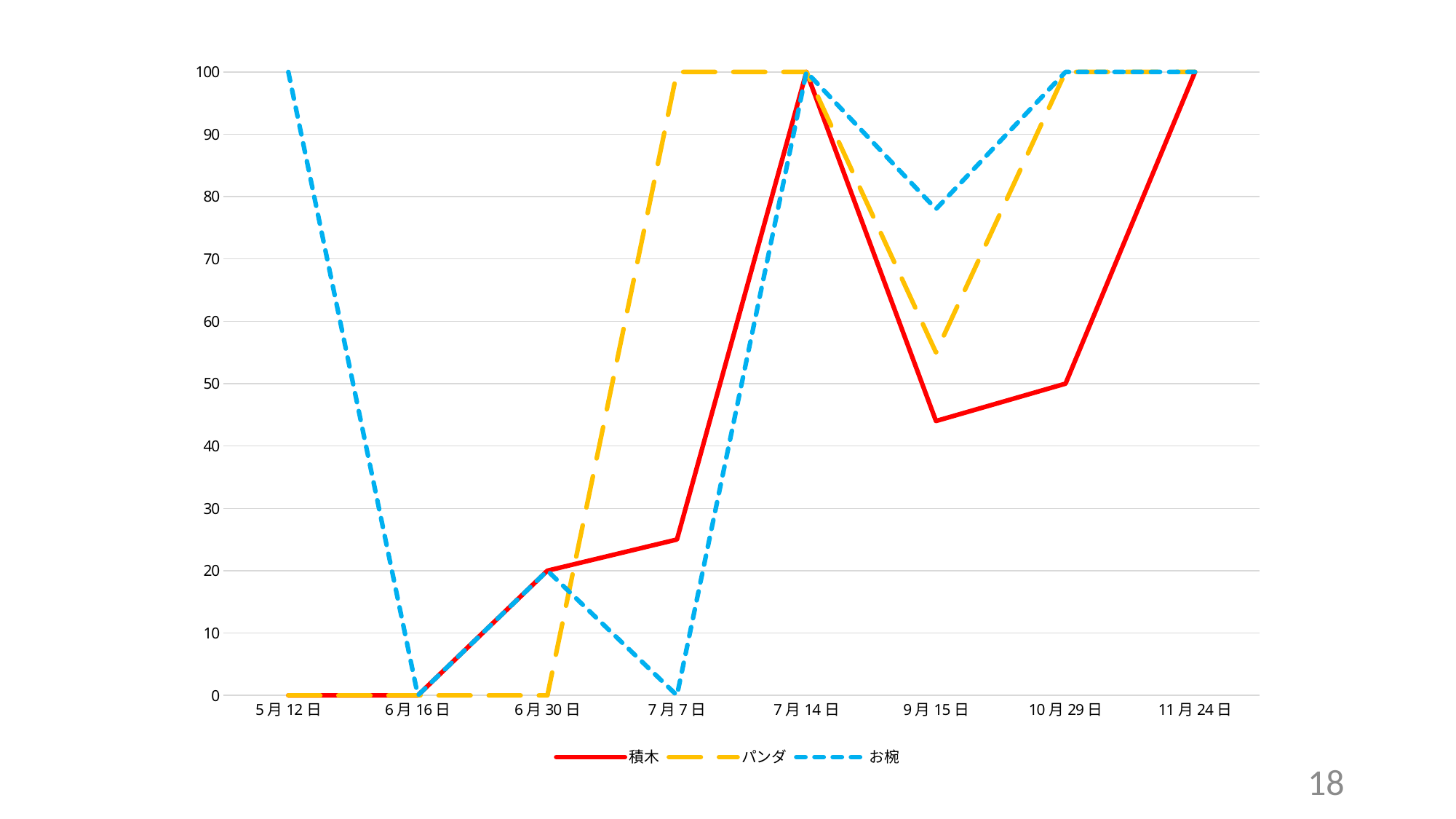
What kind of chart is shown on the slide? line chart What is the value for お椀 on 5月12日? 100 How many dates are shown on the x axis? 8 Is the value for 積木 on 9月15日 greater or less than 50? less On 9月15日, which series has the higher value, お椀 or 積木? お椀 Which series is drawn with a solid red line? 積木 Is the value for お椀 on 9月15日 greater or less than 70? greater What is the difference between the 積木 values on 11月24日 and 10月29日? 50 What is the value for パンダ on 7月7日? 100 What is the value for 積木 on 6月30日? 20 How many series does the legend list? 3 What is the value for 積木 on 10月29日? 50